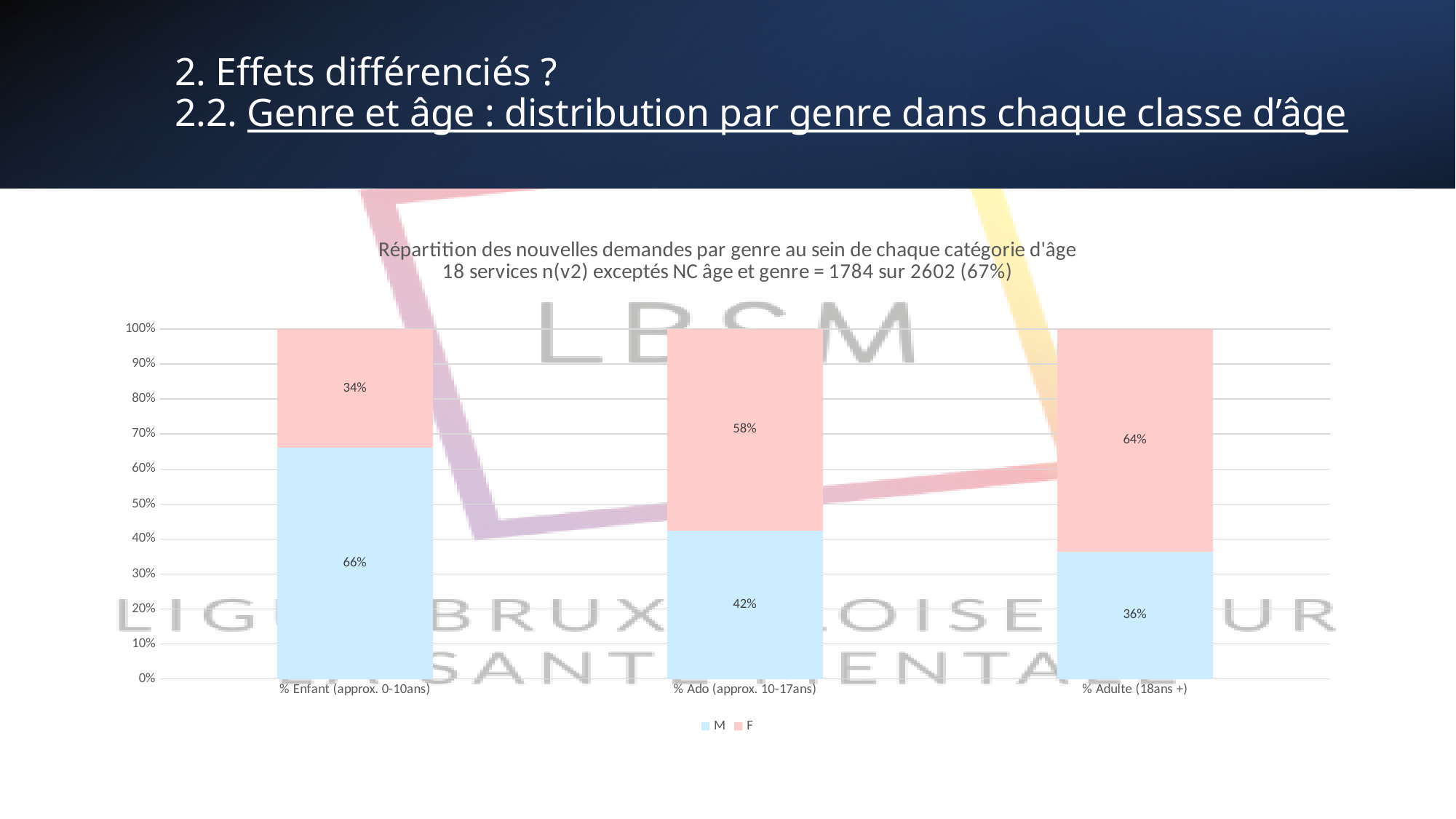
Which is larger in the % Ado (approx. 10-17ans) category, M or F? F How many age categories are shown on the x axis? 3 What is the value for F in the % Ado (approx. 10-17ans) category? 58% What kind of chart is shown on the slide? Stacked bar chart What is the value for M in the % Enfant (approx. 0-10ans) category? 66% Which category has the lowest value for F? % Enfant (approx. 0-10ans) Does the value for M rise or fall from % Enfant (approx. 0-10ans) to % Adulte (18ans +)? Fall How many series does the legend list? 2 Which category has the highest value for M? % Enfant (approx. 0-10ans) What is the value for F in the % Adulte (18ans +) category? 64% What is the value for M in the % Adulte (18ans +) category? 36% What is the difference between the M value for % Enfant (approx. 0-10ans) and the M value for % Ado (approx. 10-17ans)? 24%